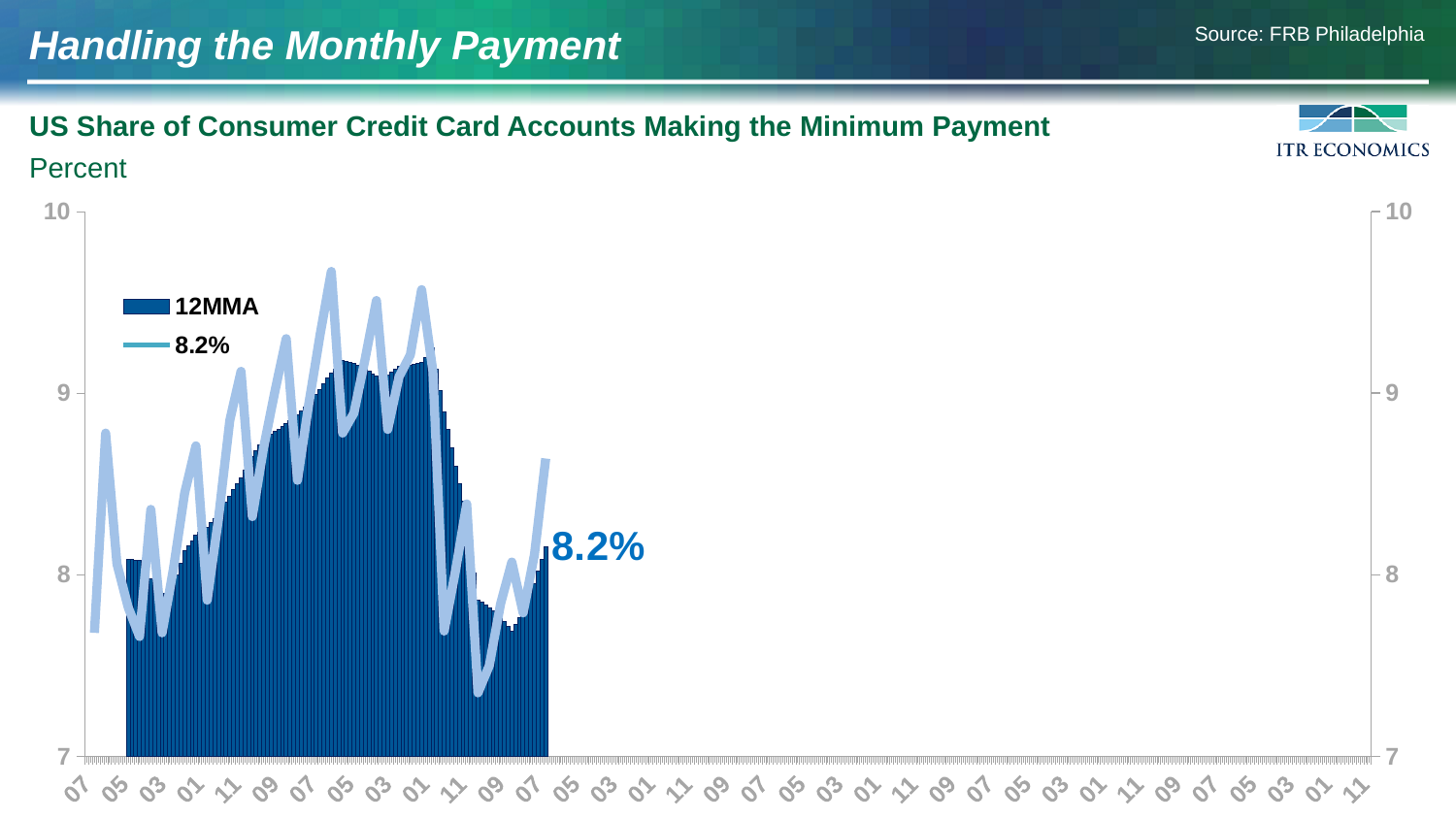
What is the latest value labeled on the chart? 8.2% What is the title of the chart? US Share of Consumer Credit Card Accounts Making the Minimum Payment Is the final labeled value of 8.2% greater or less than 9? less What kind of chart is shown on the slide? Bar chart with a line overlay What is the maximum value shown on the vertical axis? 10 Is the tallest 12MMA bar greater or less than 9? greater Do the 12MMA bars rise or fall from their peak to the end of the plotted data? fall How many series does the chart's legend list? 2 Is the highest point of the line series greater or less than 9? greater What is the name of the series plotted as bars? 12MMA